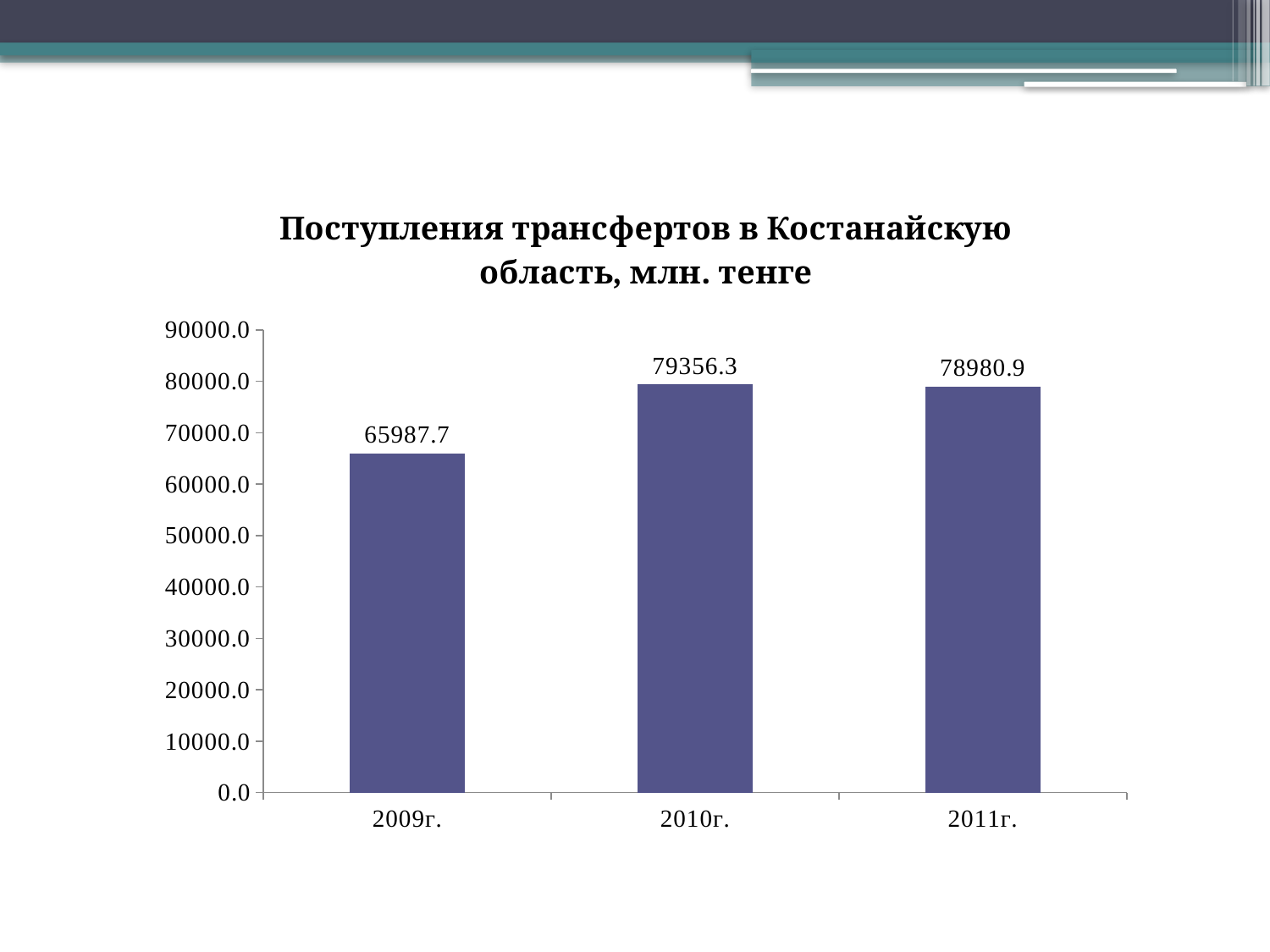
What type of chart is shown on the slide? Bar chart Is the value for 2009г. greater or less than 70000.0? less What is the value for 2009г.? 65987.7 What is the title of the chart? Поступления трансфертов в Костанайскую область, млн. тенге What is the value for 2011г.? 78980.9 What is the difference between the values for 2011г. and 2009г.? 12993.2 Which year has the lowest value? 2009г. Which is larger, the value for 2009г. or the value for 2011г.? 2011г. Which year has the highest value according to the data labels? 2010г. How many years are shown on the x axis? 3 What is the value for 2010г.? 79356.3 What is the difference between the values for 2010г. and 2009г.? 13368.6